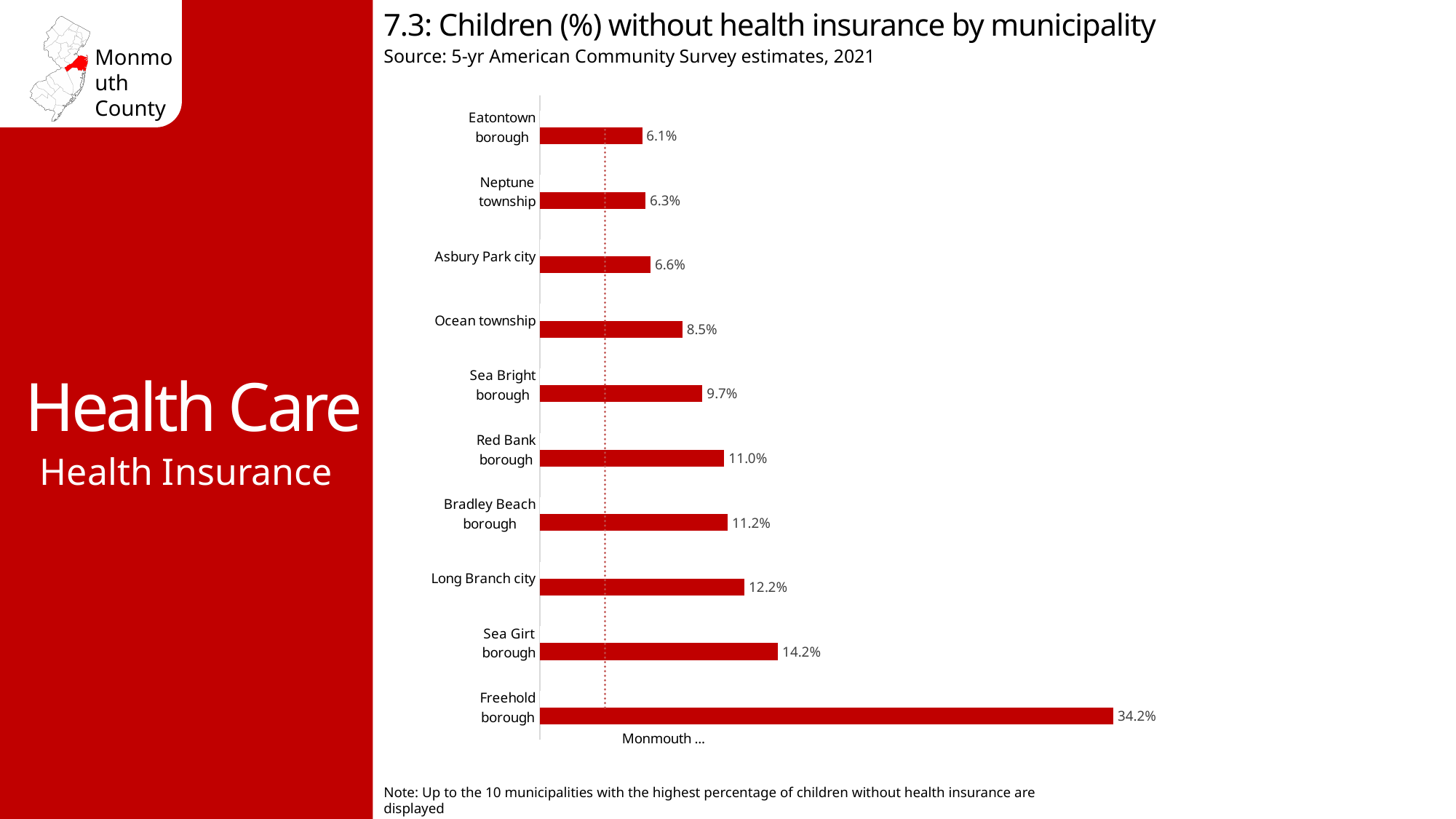
What is the percentage of children without health insurance in Freehold borough? 34.2% What kind of chart is shown on the slide? Bar chart Which municipality has the highest percentage of children without health insurance? Freehold borough Which has a lower value, Neptune township or Ocean township? Neptune township What is the difference between the values for Red Bank borough and Asbury Park city? 4.4% What is the value shown for Ocean township? 8.5% What is the value shown for Long Branch city? 12.2% Which has a higher value, Sea Bright borough or Bradley Beach borough? Bradley Beach borough How many municipalities are shown in the chart? 10 What is the difference between the values for Freehold borough and Sea Girt borough? 20.0% Which municipality has the lowest percentage of children without health insurance? Eatontown borough What is the source cited for the chart data? 5-yr American Community Survey estimates, 2021